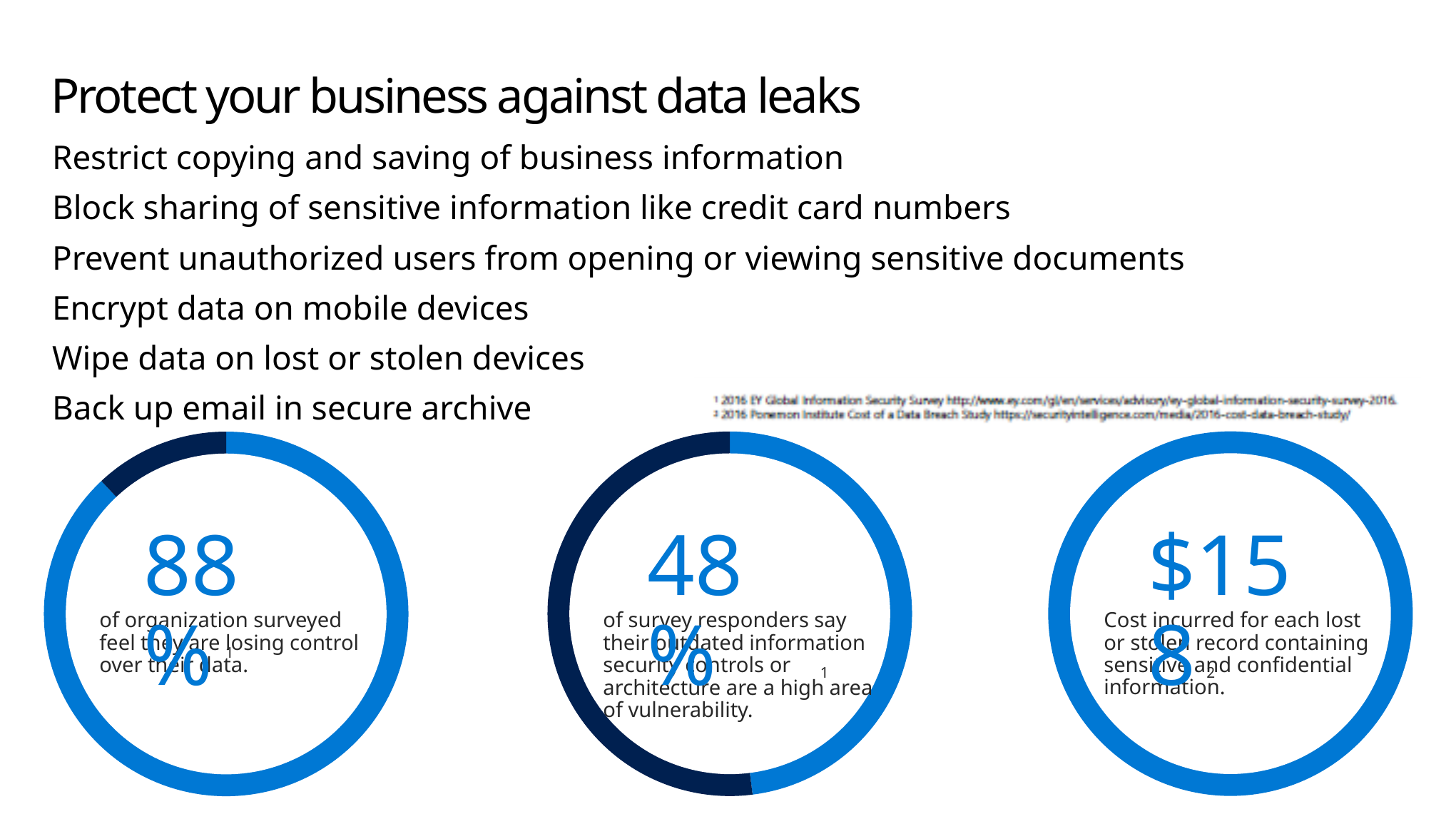
Which is larger: the percentage in the left donut chart or the percentage in the middle donut chart? The left donut chart (88%) In the left donut chart, is the dark navy portion greater or less than 25% of the ring? less In the left donut chart, what percentage of organizations surveyed feel they are losing control over their data? 88% How many donut charts are shown on the slide? 3 What colour is used for the filled (highlighted) portion of the rings in the donut charts? Light blue What is the difference in percentage points between the left donut chart's value (88%) and the middle donut chart's value (48%)? 40 percentage points What kind of chart is used for the three statistics at the bottom of the slide? Donut (ring) chart Which donut chart's ring is entirely light blue with no dark navy segment? The right chart (cost per lost or stolen record) In the left donut chart, is the light blue filled portion greater or less than 50% of the ring? greater Of the two percentage donut charts, which one shows the lowest value? The middle chart (48%) In the middle donut chart, what percentage of survey responders say their outdated information security controls or architecture are a high area of vulnerability? 48%